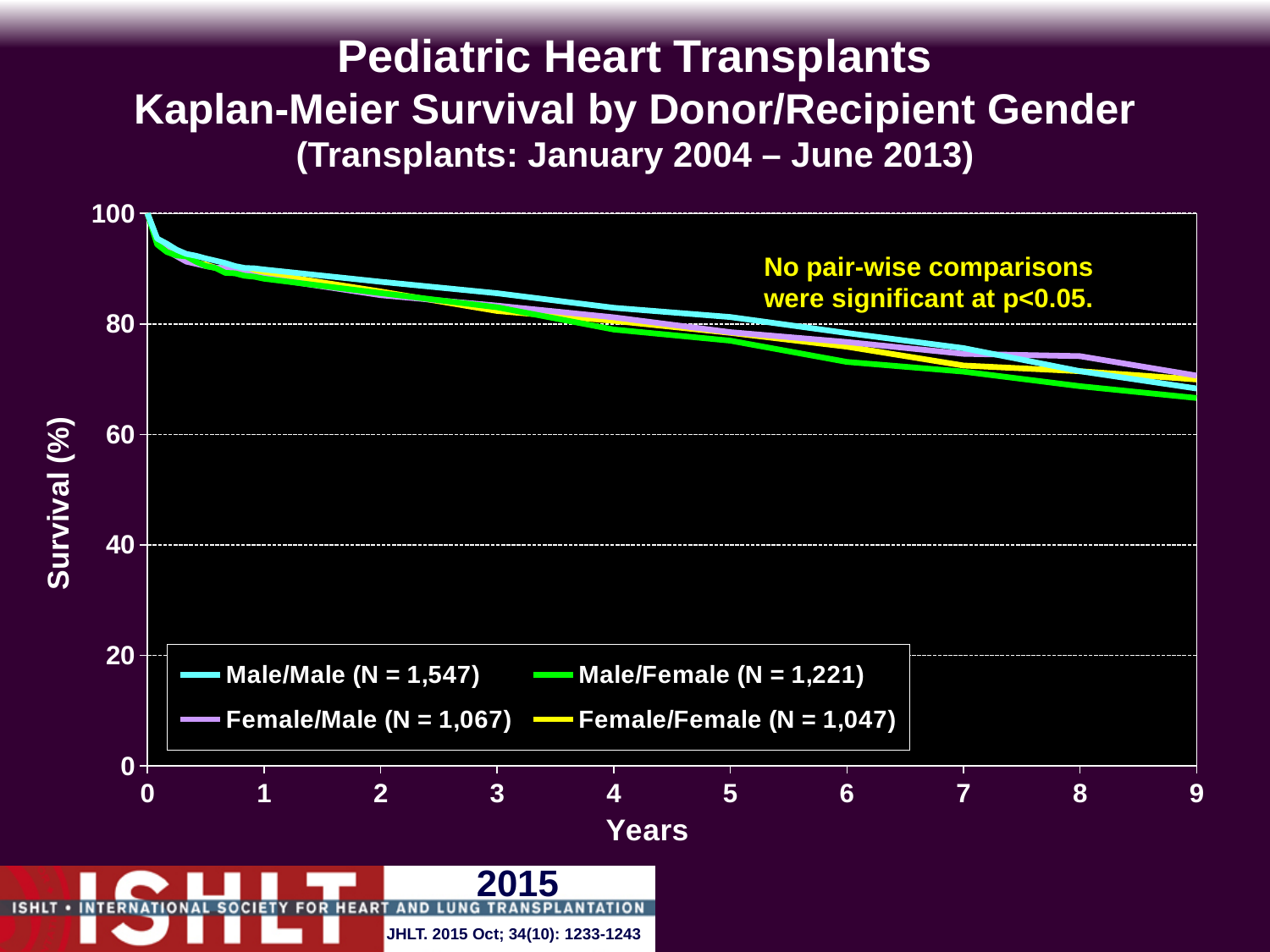
What is the N for the Male/Male group shown in the legend? 1,547 How many series does the legend list? 4 What is the N for the Female/Female group shown in the legend? 1,047 Which donor/recipient gender group has the lowest survival curve at year 9? Male/Female Is the survival value for Female/Female at year 1 greater or less than 80? greater Do the survival curves rise or fall as the years increase? Fall What transplant date range is given in the chart title? January 2004 – June 2013 Is the survival value for Female/Male at year 5 greater or less than 60? greater Is the survival value for Male/Female at year 9 greater or less than 80? less What kind of chart is shown on the slide? Line chart What is the label of the y axis? Survival (%)